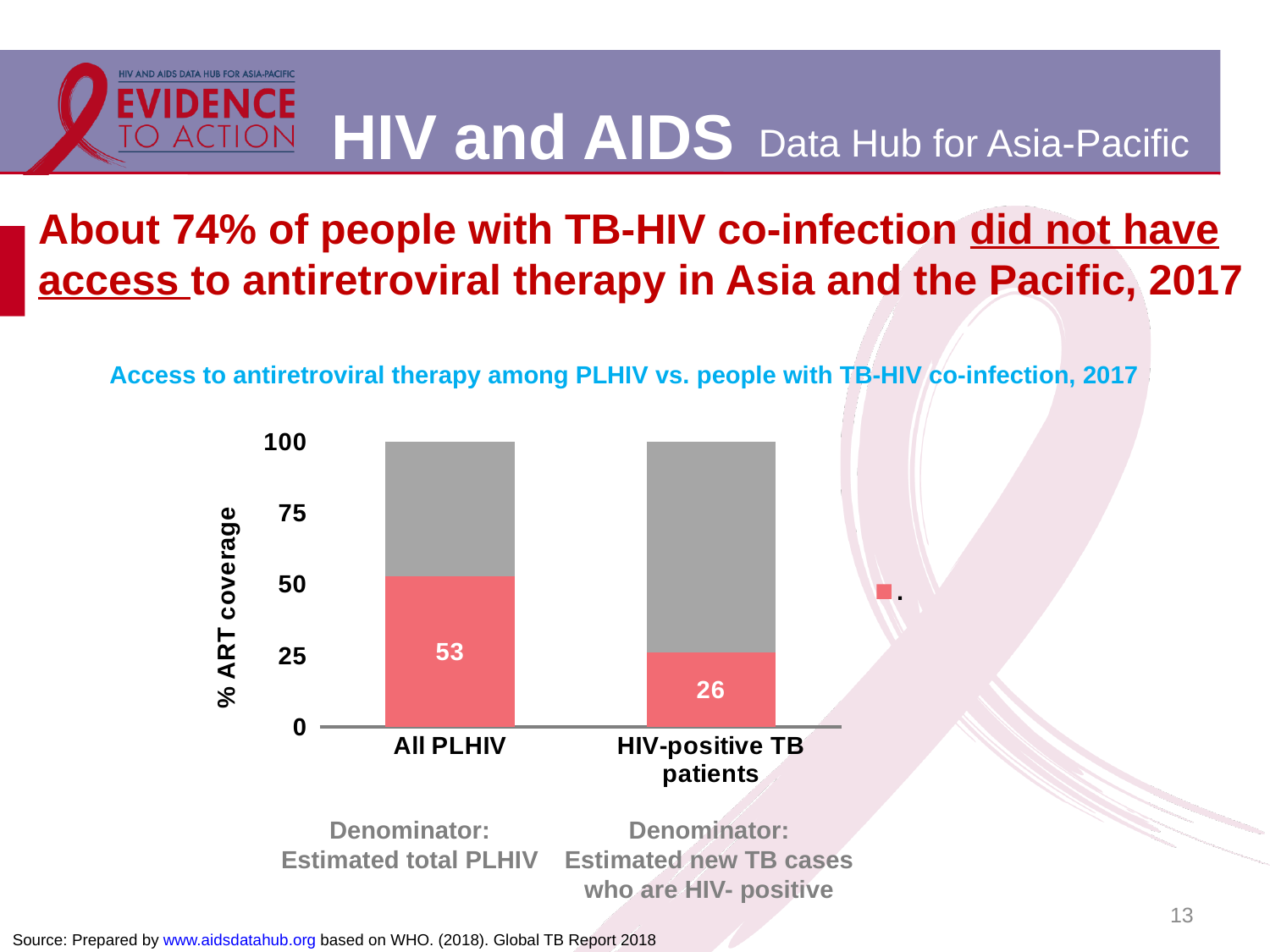
Which category has the lower ART coverage value? HIV-positive TB patients Is the ART coverage value for All PLHIV greater or less than 25? greater What kind of chart is shown on the slide? bar chart What is the % ART coverage value shown for HIV-positive TB patients? 26 What is the % ART coverage value shown for All PLHIV? 53 Is the ART coverage value for HIV-positive TB patients greater or less than 50? less What is the title of the chart? Access to antiretroviral therapy among PLHIV vs. people with TB-HIV co-infection, 2017 What is the difference between the ART coverage values for All PLHIV and HIV-positive TB patients? 27 How many categories are shown on the x axis of the chart? 2 Which category has the higher ART coverage value? All PLHIV What is the label on the y axis of the chart? % ART coverage Is the ART coverage value for All PLHIV larger or smaller than that for HIV-positive TB patients? larger